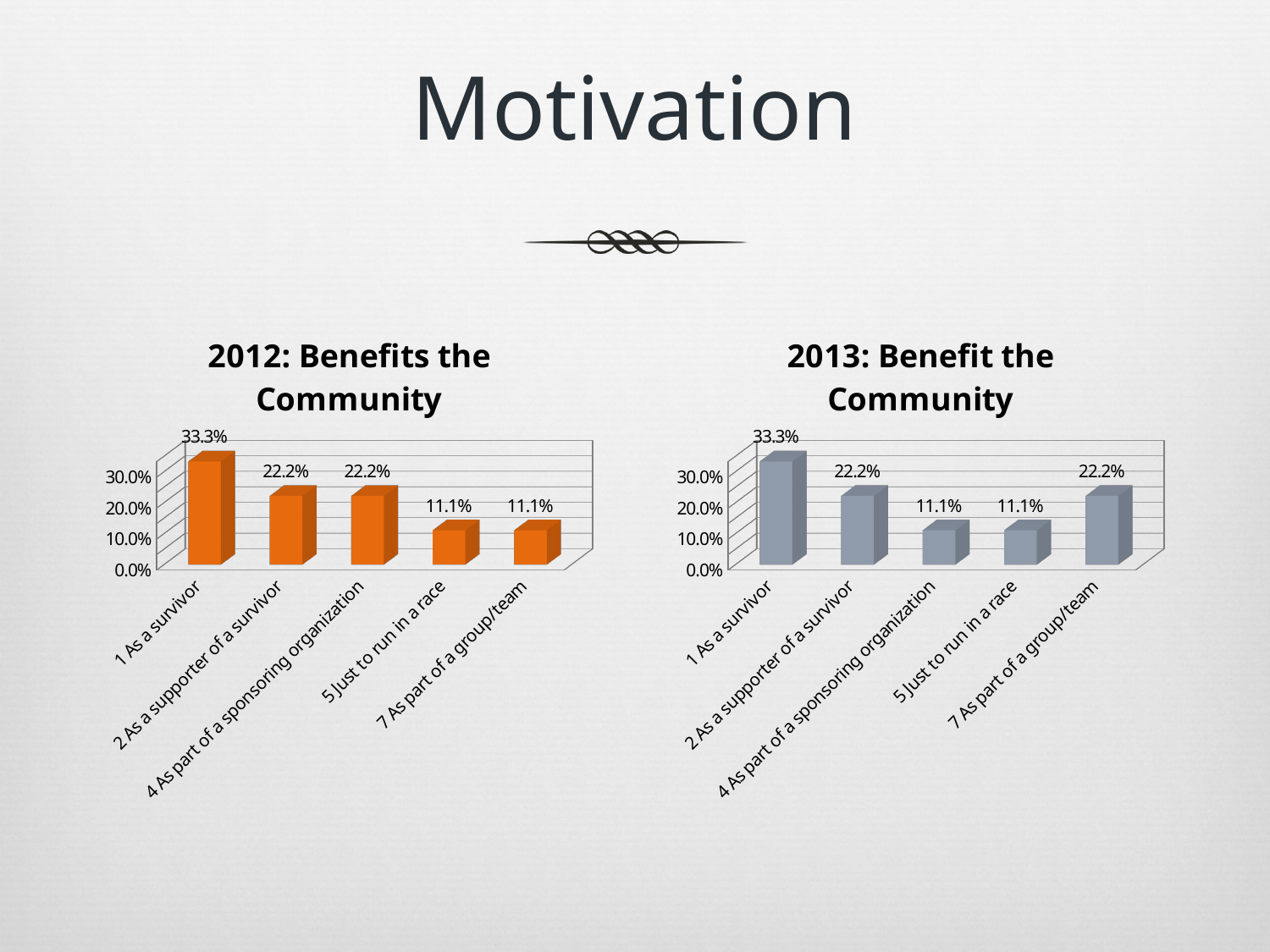
In the '2013: Benefit the Community' chart, what is the value for '4 As part of a sponsoring organization'? 11.1% In the '2012: Benefits the Community' chart, is the value for '2 As a supporter of a survivor' greater or less than 30.0%? less What kind of chart is the '2013: Benefit the Community' chart? Bar chart In the '2012: Benefits the Community' chart, what is the difference between '1 As a survivor' and '2 As a supporter of a survivor'? 11.1% How many categories are shown in the '2012: Benefits the Community' chart? 5 In the '2012: Benefits the Community' chart, which category has the highest value? 1 As a survivor In the '2012: Benefits the Community' chart, what is the value for '5 Just to run in a race'? 11.1% In the '2013: Benefit the Community' chart, which category has the highest value? 1 As a survivor In the '2013: Benefit the Community' chart, what is the value for '7 As part of a group/team'? 22.2% What colour are the bars in the '2012: Benefits the Community' chart? Orange In the '2012: Benefits the Community' chart, what is the value for '1 As a survivor'? 33.3% In the '2013: Benefit the Community' chart, which is larger: '4 As part of a sponsoring organization' or '7 As part of a group/team'? 7 As part of a group/team